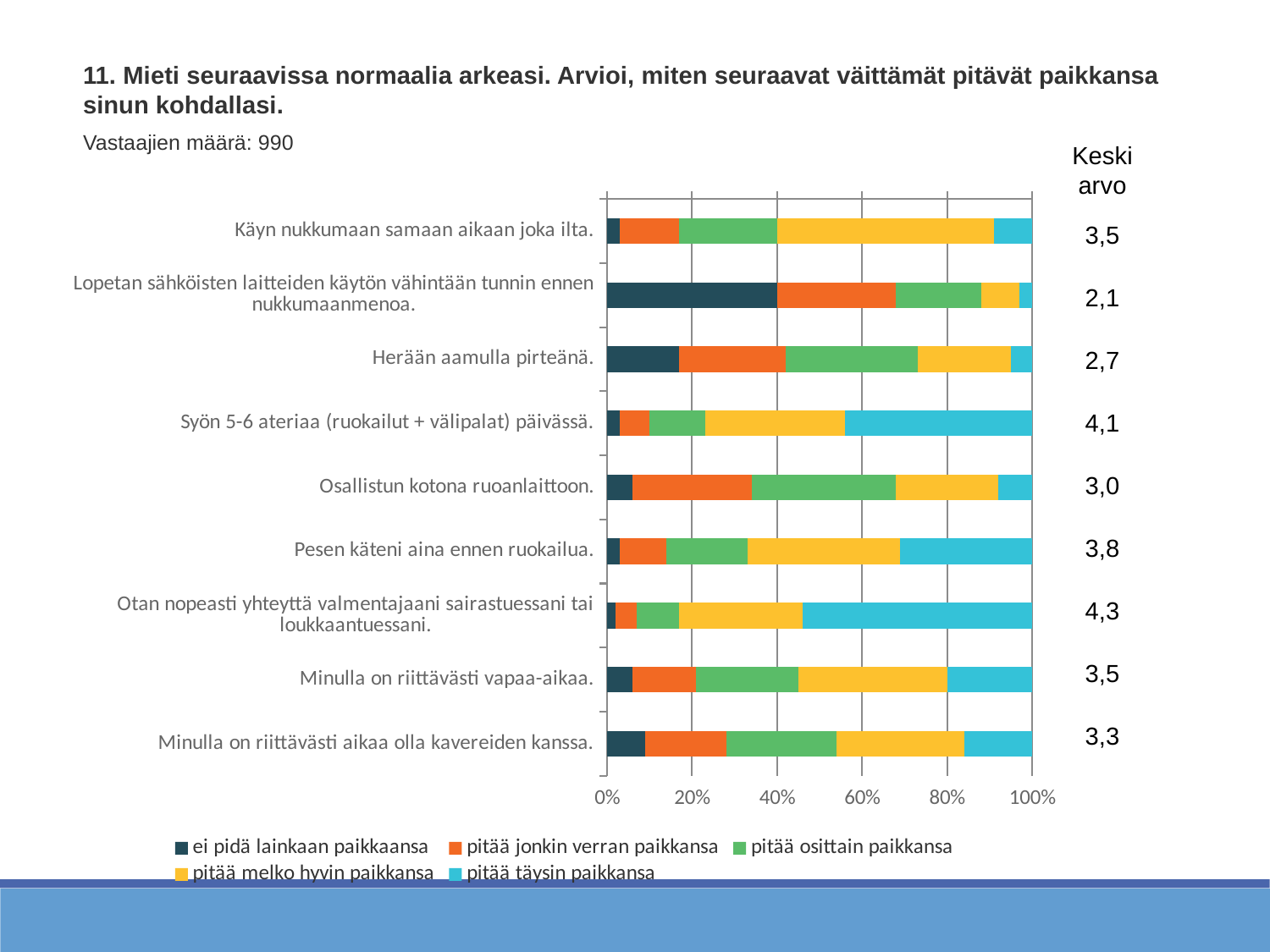
What is the mean value (Keskiarvo) shown for "Syön 5-6 ateriaa (ruokailut + välipalat) päivässä."? 4,1 What is the mean value (Keskiarvo) shown for "Herään aamulla pirteänä."? 2,7 Which has a higher mean value: "Pesen käteni aina ennen ruokailua." or "Osallistun kotona ruoanlaittoon."? Pesen käteni aina ennen ruokailua. What kind of chart is shown on the slide? Stacked bar chart Which statement has the highest mean value (Keskiarvo)? Otan nopeasti yhteyttä valmentajaani sairastuessani tai loukkaantuessani. Is the share of "ei pidä lainkaan paikkaansa" for "Lopetan sähköisten laitteiden käytön vähintään tunnin ennen nukkumaanmenoa." greater or less than 20%? greater Is the share of "pitää täysin paikkansa" for "Otan nopeasti yhteyttä valmentajaani sairastuessani tai loukkaantuessani." greater or less than 40%? greater Which statement has the lowest mean value (Keskiarvo)? Lopetan sähköisten laitteiden käytön vähintään tunnin ennen nukkumaanmenoa. How many statements (categories) are plotted in the chart? 9 What is the difference between the highest mean value (4,3) and the lowest mean value (2,1)? 2,2 How many series does the legend list? 5 How many respondents (Vastaajien määrä) does the slide report? 990